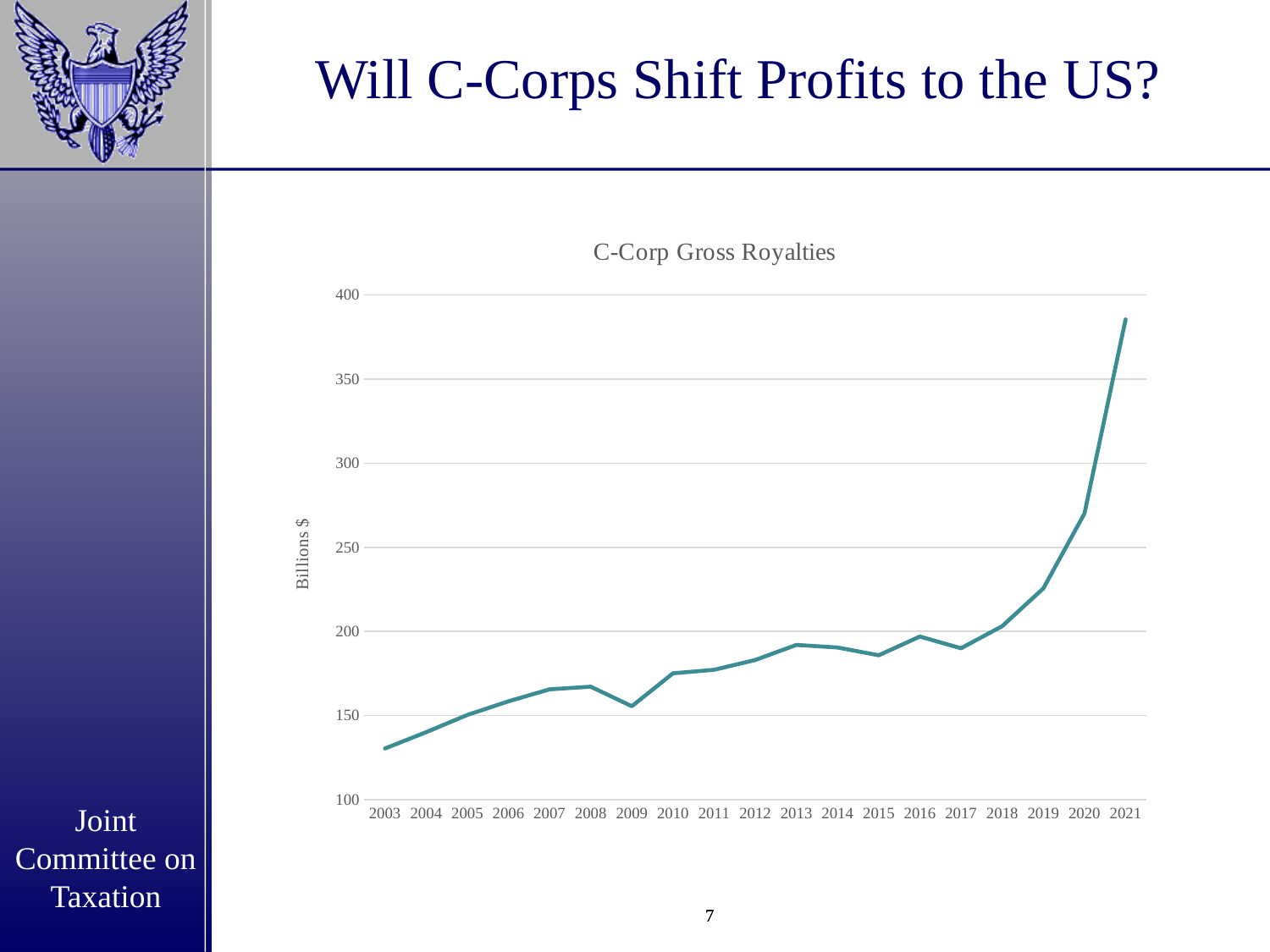
Which year has the lowest value for C-Corp Gross Royalties? 2003 How many years are plotted on the x axis of the chart? 19 Overall, do C-Corp Gross Royalties rise or fall from 2003 to 2021? rise Is the value for 2021 greater or less than 350? greater Which year has the larger value, 2008 or 2009? 2008 What kind of chart is shown on the slide? line chart What is the label on the vertical axis of the chart? Billions $ Is the value for 2003 greater or less than 150? less Is the value for 2020 greater or less than 250? greater What is the title of the chart? C-Corp Gross Royalties Which year has the highest value for C-Corp Gross Royalties? 2021